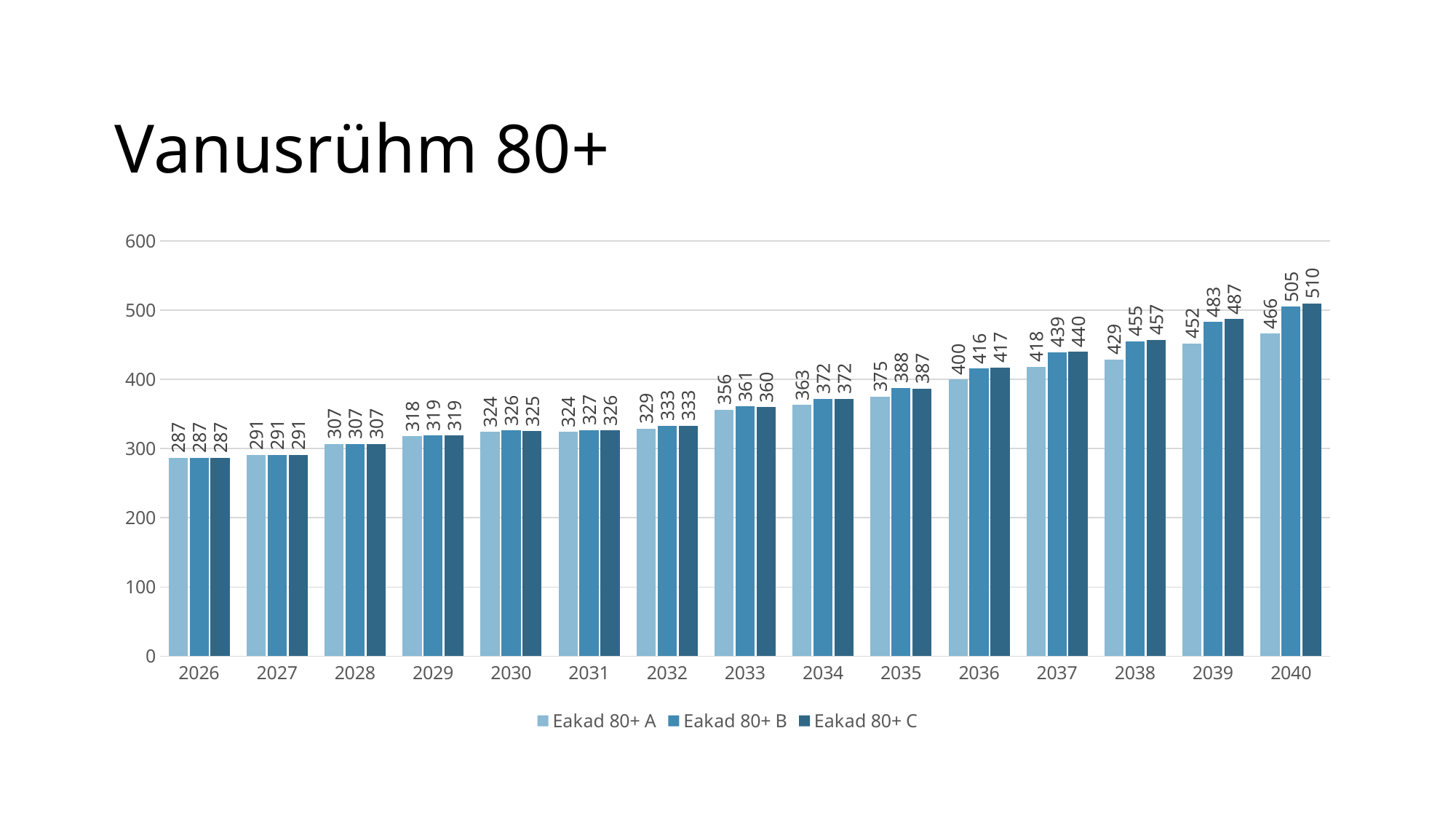
What is the difference between Eakad 80+ C and Eakad 80+ A in 2040? 44 How many years are shown on the x axis? 15 Which year has the highest value for Eakad 80+ B? 2040 Which is larger in 2037: Eakad 80+ A or Eakad 80+ B? Eakad 80+ B How many series does the legend list? 3 What is the value for Eakad 80+ B in 2035? 388 Do the values for Eakad 80+ A rise or fall from 2026 to 2040? rise What is the value for Eakad 80+ C in 2040? 510 What kind of chart is shown on the slide? bar chart What is the value for Eakad 80+ A in 2026? 287 Which year has the lowest value for Eakad 80+ C? 2026 Is the value for Eakad 80+ A in 2036 greater or less than 300? greater